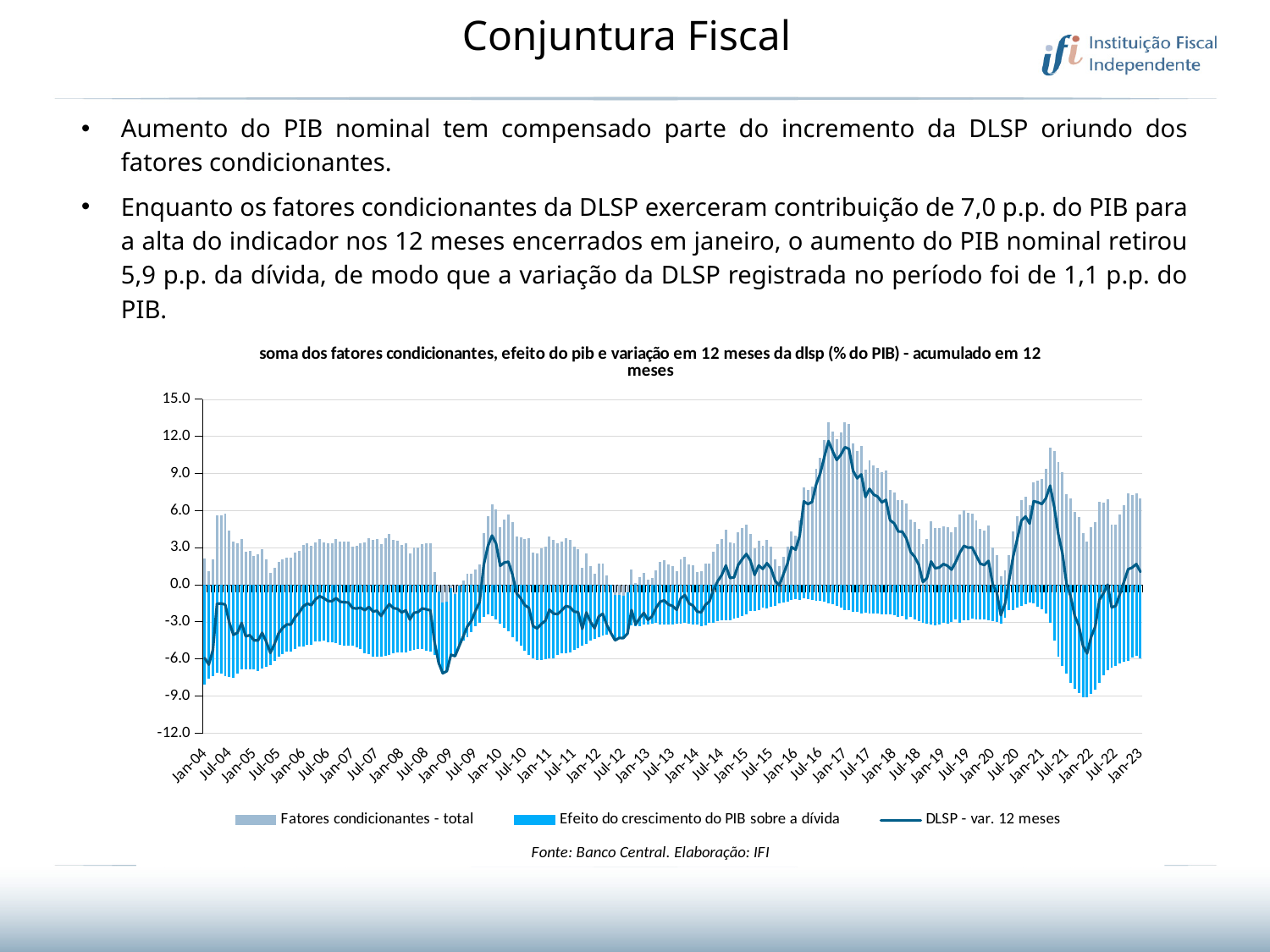
Does the DLSP - var. 12 meses line rise or fall between Jan-21 and Jan-22? fall Is the value of the Efeito do crescimento do PIB sobre a dívida bar at Jan-22 greater or less than -6.0? less Is the value of the DLSP - var. 12 meses line at Jan-17 greater or less than 9.0? greater Which is larger: the DLSP - var. 12 meses value at Jan-17 or at Jan-21? Jan-17 What kind of chart is shown on the slide? Combined bar and line chart What is the source cited below the chart? Banco Central. Elaboração: IFI Which series in the chart is drawn as a line rather than bars? DLSP - var. 12 meses Is the value of the DLSP - var. 12 meses line at Jan-09 greater or less than -3.0? less Around which date do the Efeito do crescimento do PIB sobre a dívida bars reach their lowest (most negative) value? Jan-22 How many series does the chart legend list? 3